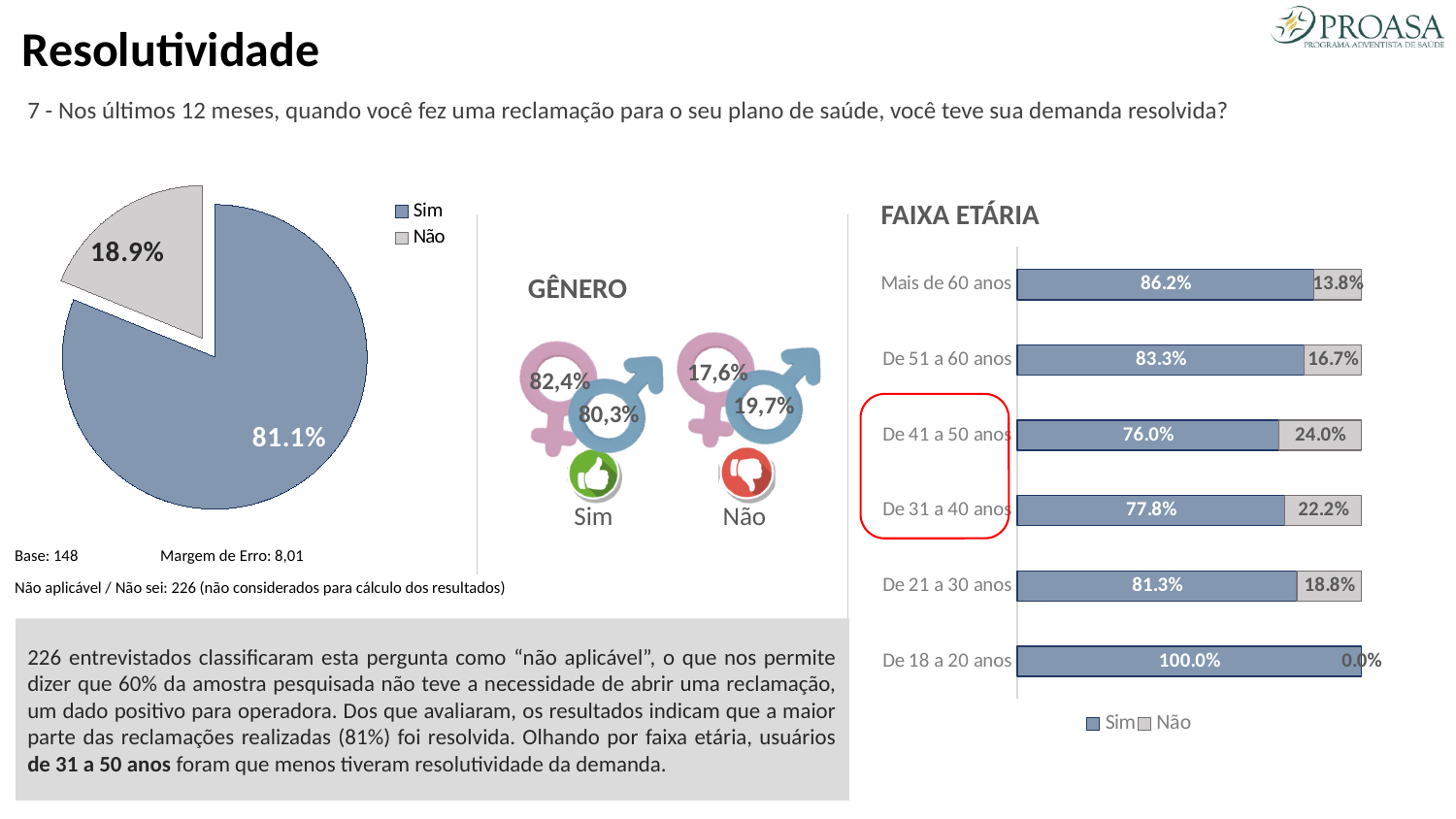
In the FAIXA ETÁRIA chart, which age group has the lowest "Sim" value? De 41 a 50 anos What kind of chart is the chart on the left of the slide? Pie chart In the FAIXA ETÁRIA chart, which is larger: the "Não" value for "De 41 a 50 anos" or for "De 21 a 30 anos"? De 41 a 50 anos In the FAIXA ETÁRIA chart, which age group has the highest "Sim" value? De 18 a 20 anos How many age groups are shown in the FAIXA ETÁRIA chart? 6 In the pie chart on the left, what is the value for "Não"? 18.9% In the FAIXA ETÁRIA chart, what is the difference between the "Sim" values for "Mais de 60 anos" and "De 31 a 40 anos"? 8.4% What kind of chart is the FAIXA ETÁRIA chart? Stacked bar chart In the FAIXA ETÁRIA chart, what is the "Sim" value for "De 41 a 50 anos"? 76.0% In the pie chart on the left, what share of respondents answered "Sim"? 81.1% In the FAIXA ETÁRIA chart, what is the "Não" value for "De 51 a 60 anos"? 16.7% How many entries does the legend of the pie chart on the left list? 2